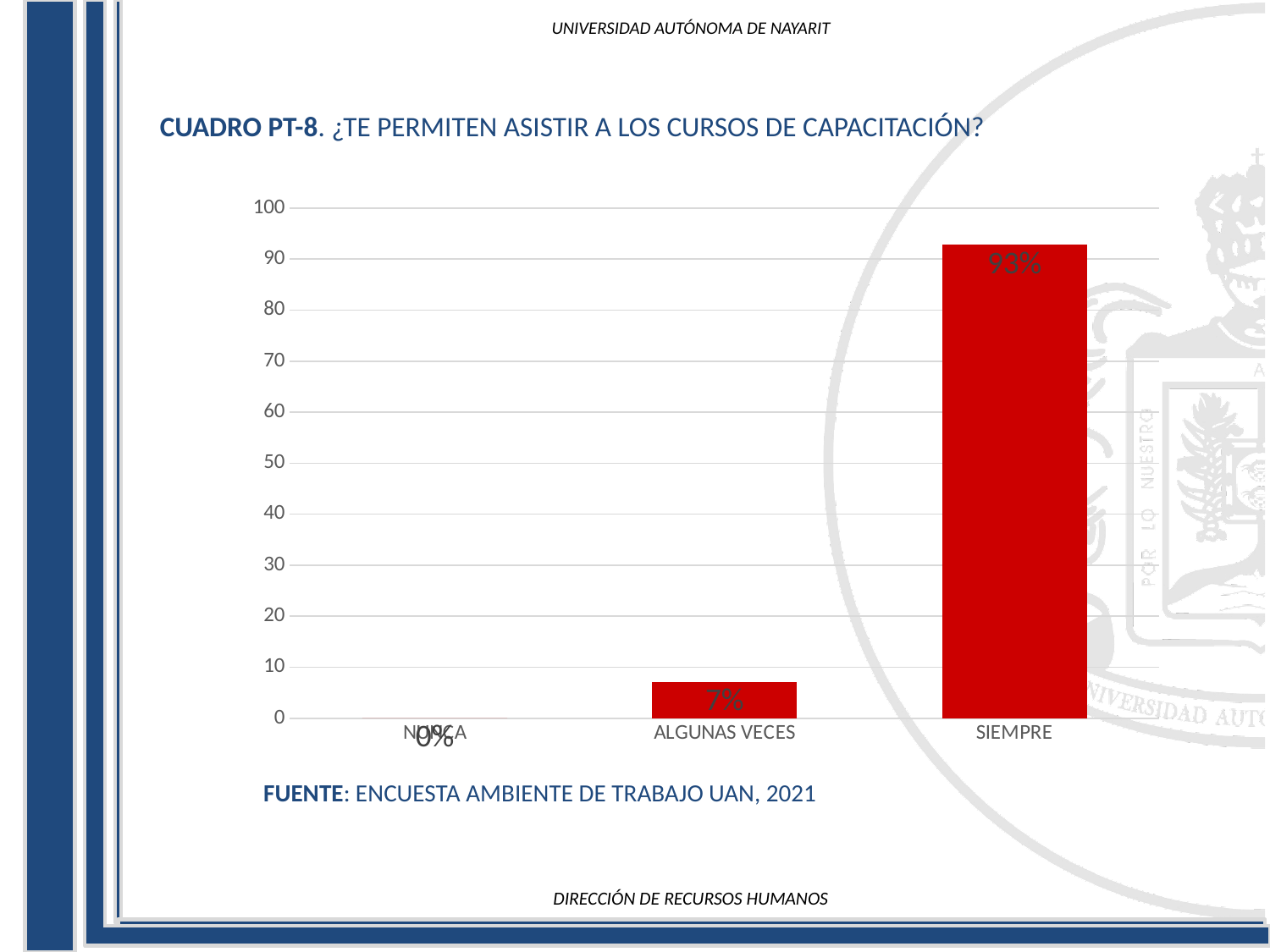
Which category has the lowest value? NUNCA Is the value for SIEMPRE greater or less than 90? greater What is the value for ALGUNAS VECES? 7% What is the value for NUNCA? 0% What source is cited below the chart? ENCUESTA AMBIENTE DE TRABAJO UAN, 2021 Which is larger, the value for ALGUNAS VECES or the value for SIEMPRE? SIEMPRE What kind of chart is shown on the slide? bar chart Which category has the highest value? SIEMPRE How many categories are shown on the x axis? 3 What is the difference between the values for SIEMPRE and ALGUNAS VECES? 86% What is the value for SIEMPRE? 93% Is the value for ALGUNAS VECES greater or less than 10? less